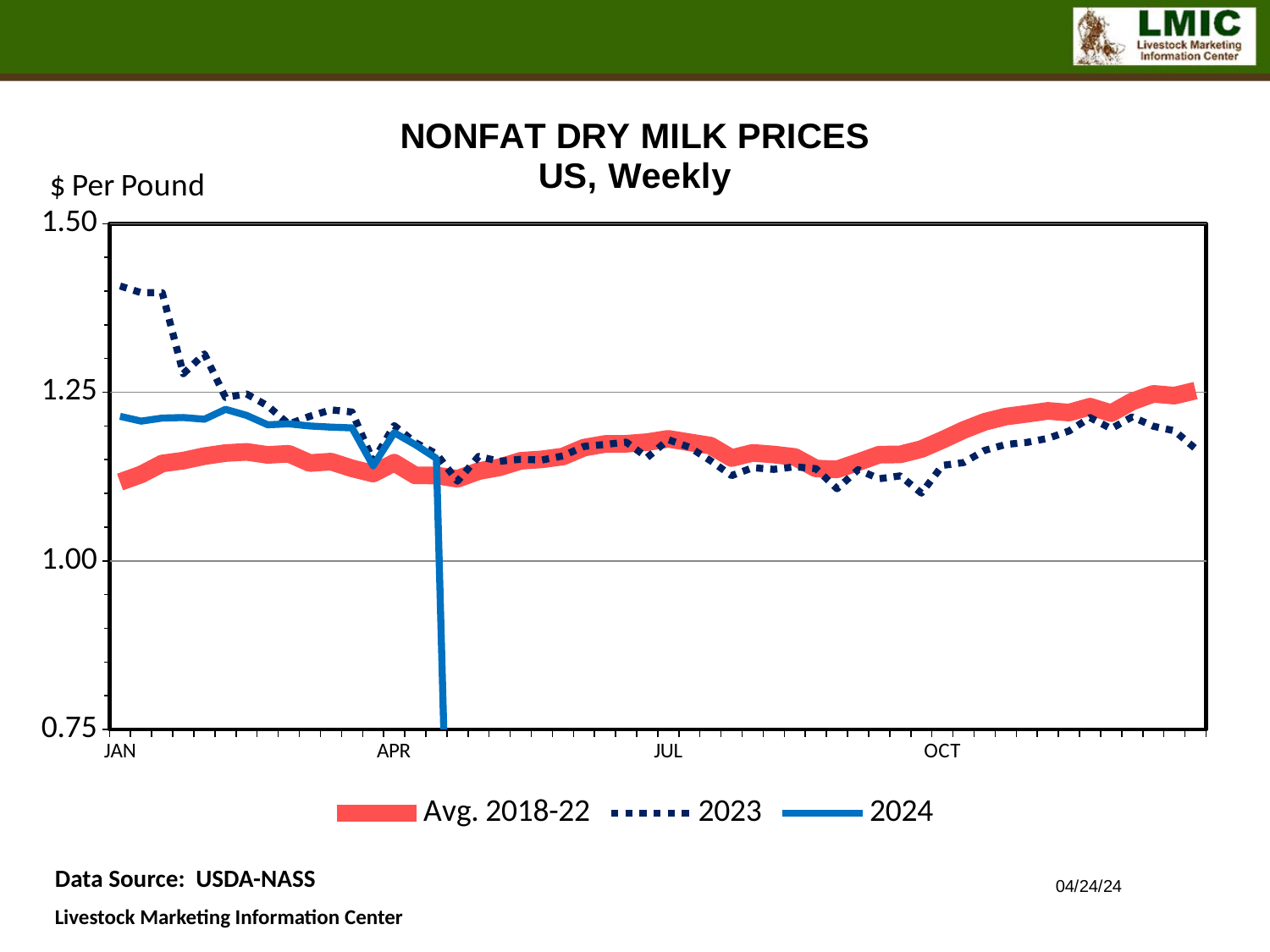
Which series has the highest value at the start of January? 2023 What kind of chart is shown on the slide? line chart Does the 2023 line rise or fall from January to April? fall At the start of January, which is higher: the 2024 line or the Avg. 2018-22 line? 2024 What unit is shown on the y axis label? $ Per Pound What is the title of the chart? NONFAT DRY MILK PRICES US, Weekly Is the 2023 value at the start of January greater or less than 1.25? greater Is the 2024 value at the start of January greater or less than 1.25? less Is the Avg. 2018-22 value at the start of January greater or less than 1.00? greater How many series does the legend list? 3 How many month labels are shown on the x axis? 4